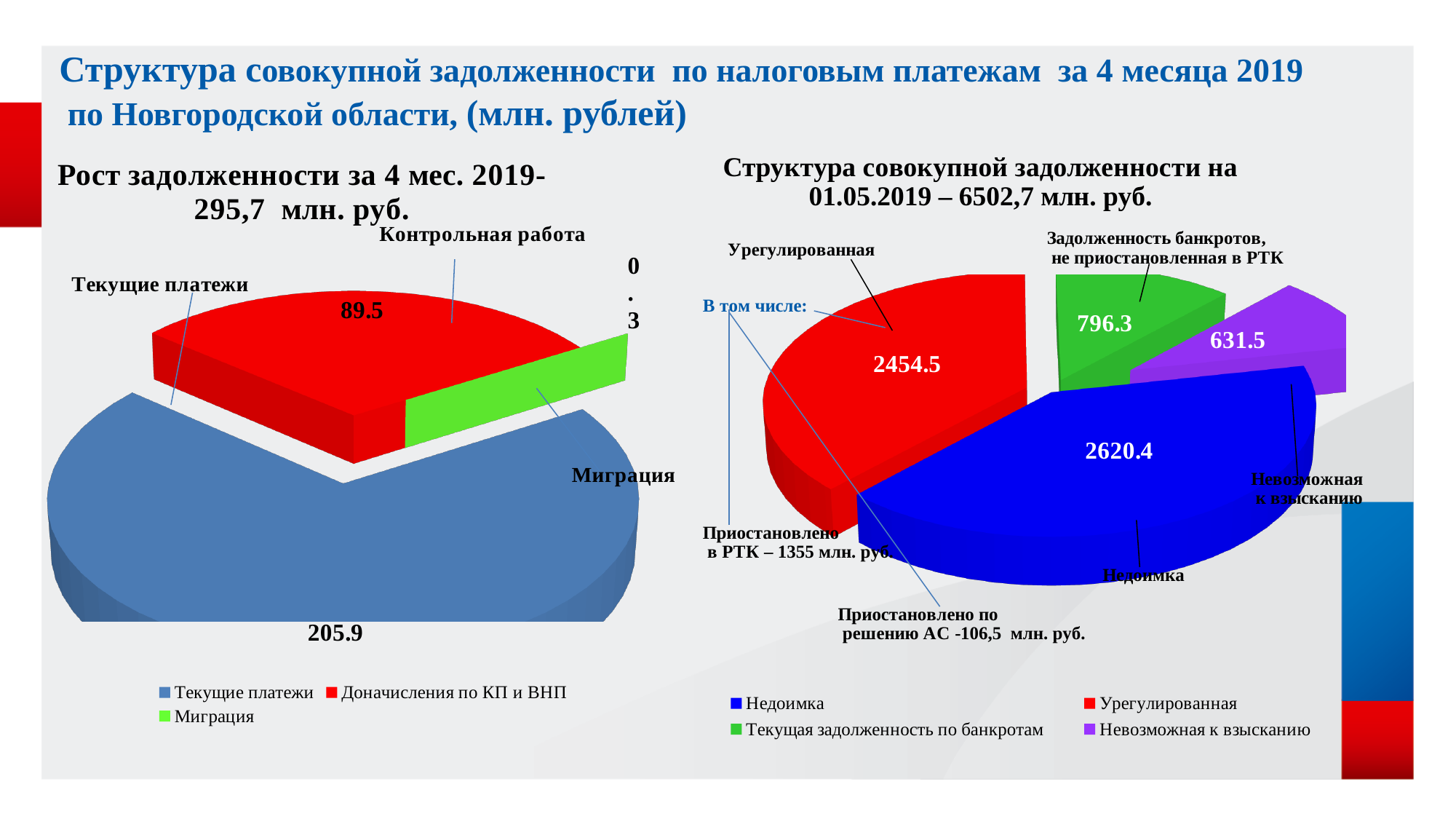
In the right pie chart (Структура совокупной задолженности на 01.05.2019), what is the value for Недоимка? 2620.4 In the left pie chart (Рост задолженности за 4 мес. 2019), what is the value for Миграция? 0.3 In the right pie chart (Структура совокупной задолженности на 01.05.2019), what is the difference between the green slice (796.3) and the purple slice (631.5)? 164.8 In the right pie chart (Структура совокупной задолженности на 01.05.2019), which category has the smallest slice? Невозможная к взысканию In the left pie chart (Рост задолженности за 4 мес. 2019), what is the difference between Текущие платежи and the red slice (89.5)? 116.4 In the left pie chart (Рост задолженности за 4 мес. 2019), which category has the largest slice? Текущие платежи In the left pie chart (Рост задолженности за 4 мес. 2019), what is the value labelled on the red slice (Контрольная работа)? 89.5 How many series does the legend of the right pie chart (Структура совокупной задолженности на 01.05.2019) list? 4 In the right pie chart (Структура совокупной задолженности на 01.05.2019), what is the value for Невозможная к взысканию? 631.5 In the right pie chart (Структура совокупной задолженности на 01.05.2019), which is larger: Недоимка or Урегулированная? Недоимка In the right pie chart (Структура совокупной задолженности на 01.05.2019), what is the value for Урегулированная? 2454.5 In the left pie chart (Рост задолженности за 4 мес. 2019), what is the value for Текущие платежи? 205.9